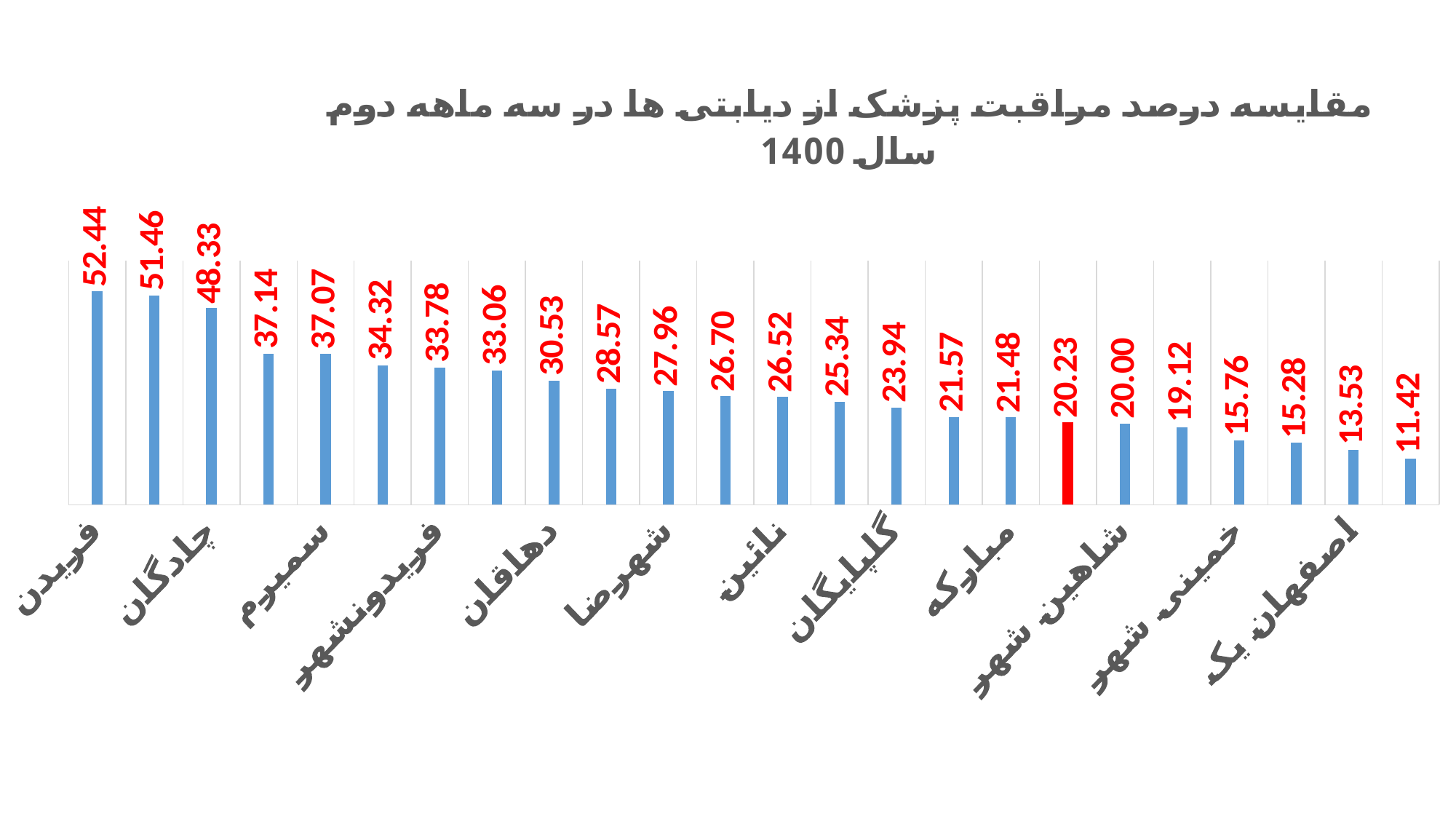
What is the lowest value shown in the chart? 11.42 Which is larger, the value for سمیرم or the value for دهاقان? سمیرم Which labelled category has the highest value? فریدن What is the value for شاهین شهر? 20.00 How many bars are plotted in the chart? 24 What is the value for فریدن? 52.44 What is the value for اصفهان یک? 13.53 What is the difference between the values for فریدن and چادگان? 4.11 Do the values rise or fall from left to right along the x axis? fall What type of chart is shown on the slide? bar chart What is the value of the bar highlighted in red? 20.23 What is the value for چادگان? 48.33